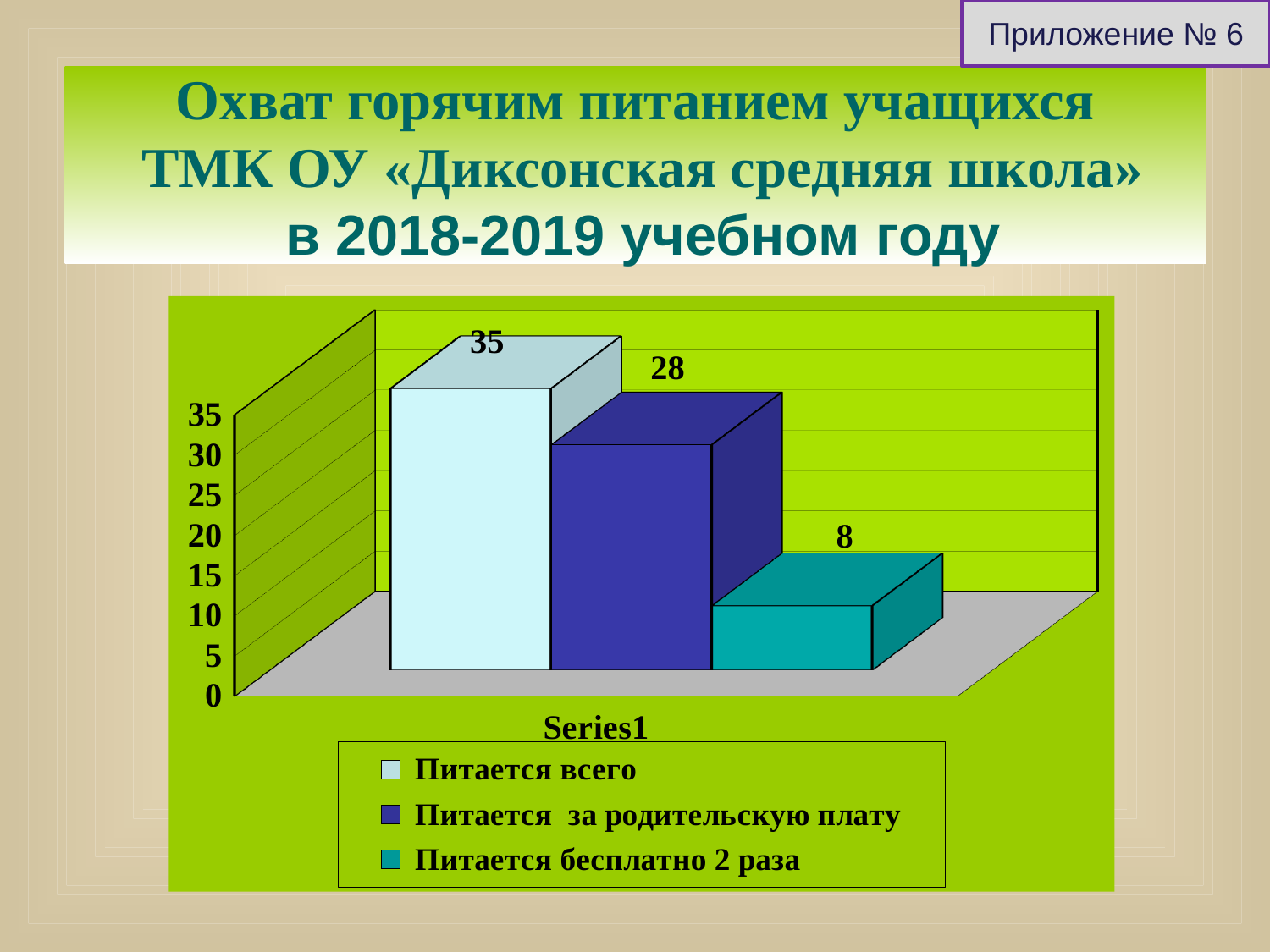
Is the value for «Питается за родительскую плату» greater or less than 25? greater What is the difference between «Питается за родительскую плату» and «Питается бесплатно 2 раза»? 20 What kind of chart is shown on the slide? bar chart What is the value for «Питается за родительскую плату»? 28 How many entries does the legend list? 3 What is the difference between «Питается всего» and «Питается за родительскую плату»? 7 What is the value for «Питается бесплатно 2 раза»? 8 What is the value for «Питается всего»? 35 Which legend entry has the highest value? Питается всего Which legend entry has the lowest value? Питается бесплатно 2 раза Which is larger: «Питается за родительскую плату» or «Питается бесплатно 2 раза»? Питается за родительскую плату How many bars are plotted on the chart? 3